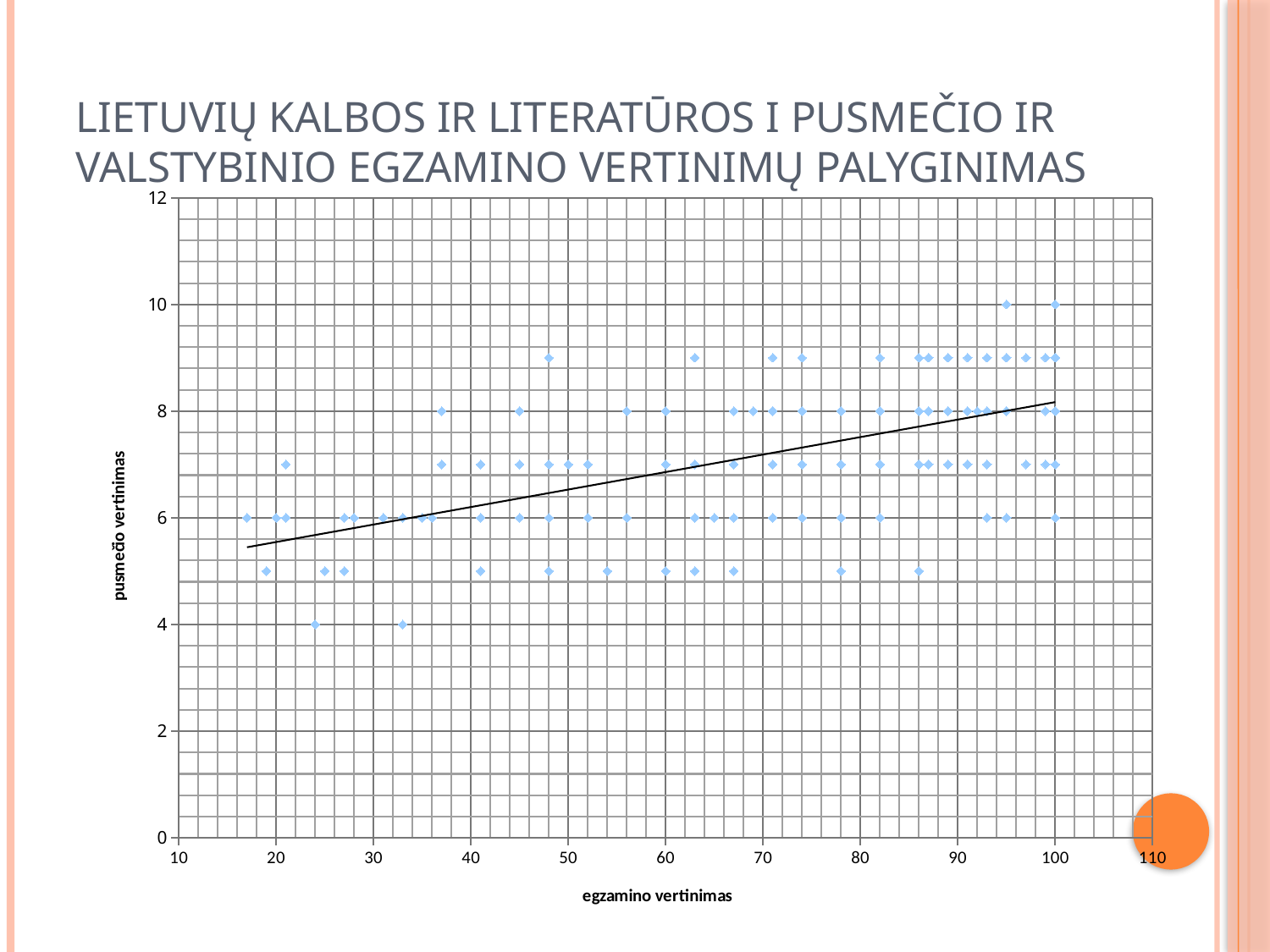
What is the lowest semester grade (pusmečio vertinimas) reached by any point on the chart? 4 Is the trend line value at an exam score of 20 greater or less than 6? less Are the points with a semester grade of 9 mostly found at exam scores greater or less than 60? greater Does the trend line rise or fall as the exam score (egzamino vertinimas) increases? rises What is the maximum value shown on the horizontal axis? 110 What is the minimum value shown on the horizontal axis? 10 What is the title of the chart? Lietuvių kalbos ir literatūros I pusmečio ir valstybinio egzamino vertinimų palyginimas Is the trend line value at an exam score of 100 greater or less than 6? greater What is the label of the horizontal axis? egzamino vertinimas What is the maximum value shown on the vertical axis? 12 What kind of chart is shown on the slide? scatter plot What is the highest semester grade (pusmečio vertinimas) reached by any point on the chart? 10